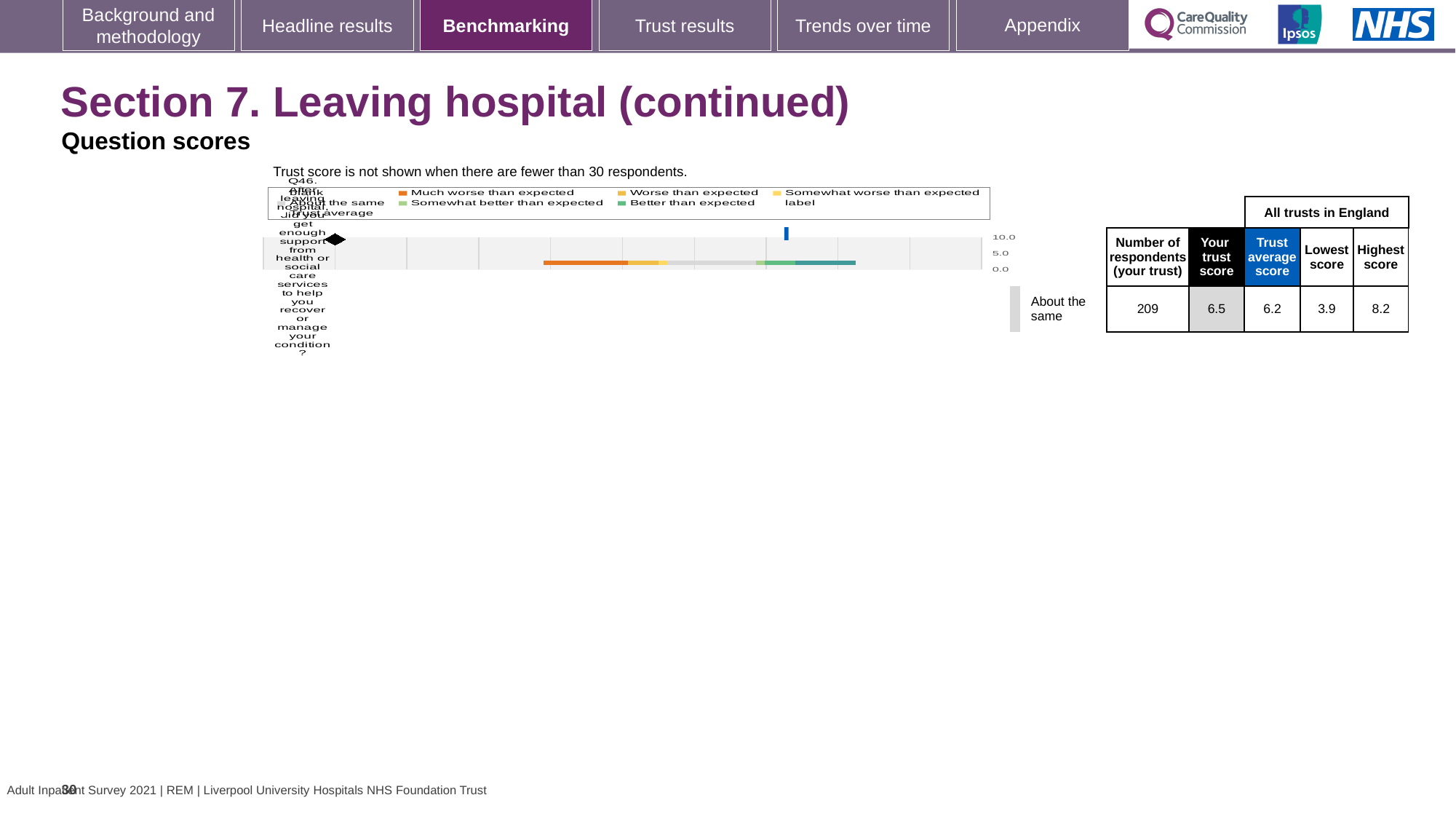
What is the difference between the highest score and the lowest score for Q46? 4.3 What is the trust average score for Q46? 6.2 Is the trust score for Q46 greater or less than 5.0? greater Which is larger for Q46, the trust's own score or the trust average score? Your trust score (6.5) What is the lowest score among all trusts in England for Q46? 3.9 What is the highest value shown on the chart's score axis? 10.0 What is the trust score for Q46 (Your trust score)? 6.5 Which benchmark category is Q46 assigned to? About the same How many questions are plotted on the chart? 1 How many respondents from the trust answered Q46? 209 What is the highest score among all trusts in England for Q46? 8.2 What kind of chart is used to show the Q46 benchmarking result? bar chart